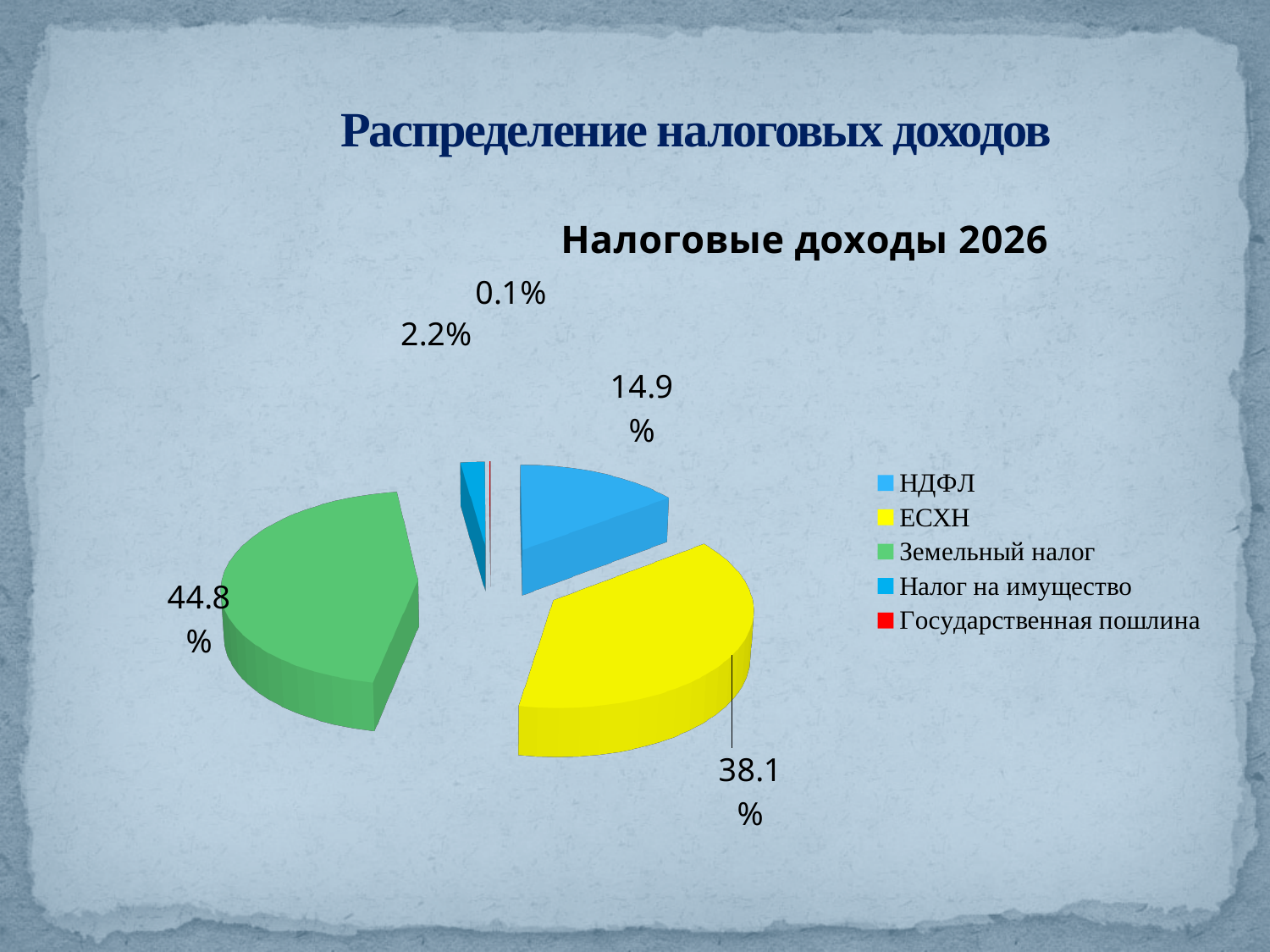
What share of the pie does ЕСХН have? 38.1% What share of the pie does Налог на имущество have? 2.2% What kind of chart is shown on the slide? Pie chart How many categories does the legend of the chart list? 5 What is the difference between the shares of Земельный налог and ЕСХН? 6.7% What share of the pie does Государственная пошлина have? 0.1% Which category has the largest share of the pie? Земельный налог Which is larger, the share of НДФЛ or the share of ЕСХН? ЕСХН What share of the pie does Земельный налог have? 44.8% Which category has the smallest share of the pie? Государственная пошлина What share of the pie does НДФЛ have? 14.9% What is the title of the chart? Налоговые доходы 2026